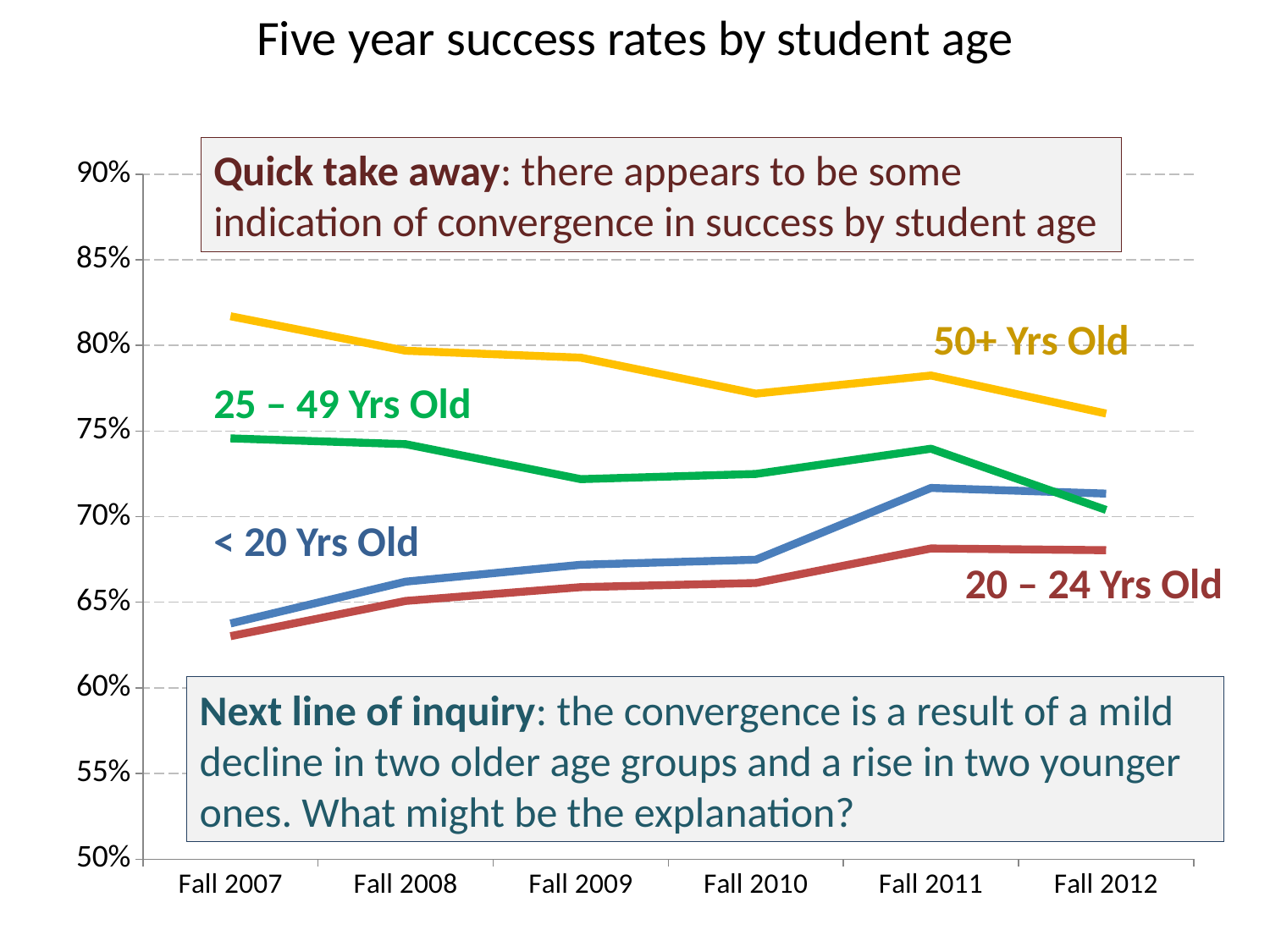
Is the value for < 20 Yrs Old in Fall 2007 greater or less than 65%? less Does the success rate for 50+ Yrs Old rise or fall from Fall 2007 to Fall 2012? fall Which age group has the highest five year success rate in Fall 2007? 50+ Yrs Old What is the title of the chart? Five year success rates by student age Does the success rate for < 20 Yrs Old rise or fall from Fall 2007 to Fall 2012? rise Is the value for 50+ Yrs Old in Fall 2007 greater or less than 80%? greater What kind of chart is shown on the slide? line chart Which age group has the lowest five year success rate in Fall 2007? 20 – 24 Yrs Old How many time points are shown along the x axis? 6 Is the value for 25 – 49 Yrs Old in Fall 2009 greater or less than 75%? less How many age-group series are plotted on the chart? 4 In Fall 2012, which is larger: the value for 50+ Yrs Old or the value for 25 – 49 Yrs Old? 50+ Yrs Old